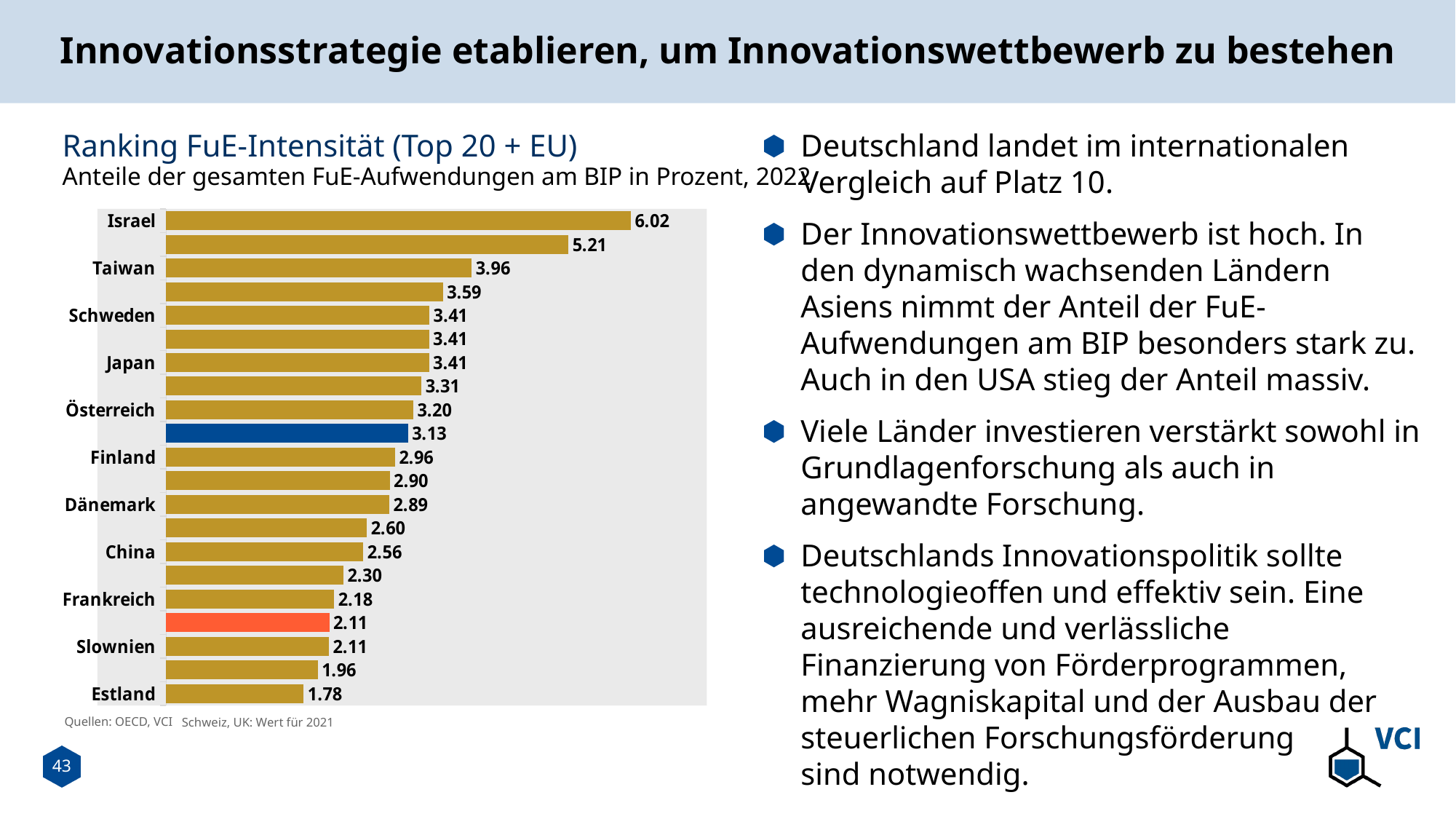
What is the difference between the values for Israel and Estland? 4.24 What is the value for Estland in the chart? 1.78 What is the value for China in the chart? 2.56 What is the value for Taiwan in the chart? 3.96 Which has the larger value, Finland or Dänemark? Finland Which country has the lowest value in the chart? Estland How many bars are plotted in the chart? 21 What is the value for Israel in the chart? 6.02 What value is printed next to the blue bar in the chart? 3.13 What is the value for Österreich in the chart? 3.20 What kind of chart is shown on the slide? Bar chart Which country has the highest value in the chart? Israel